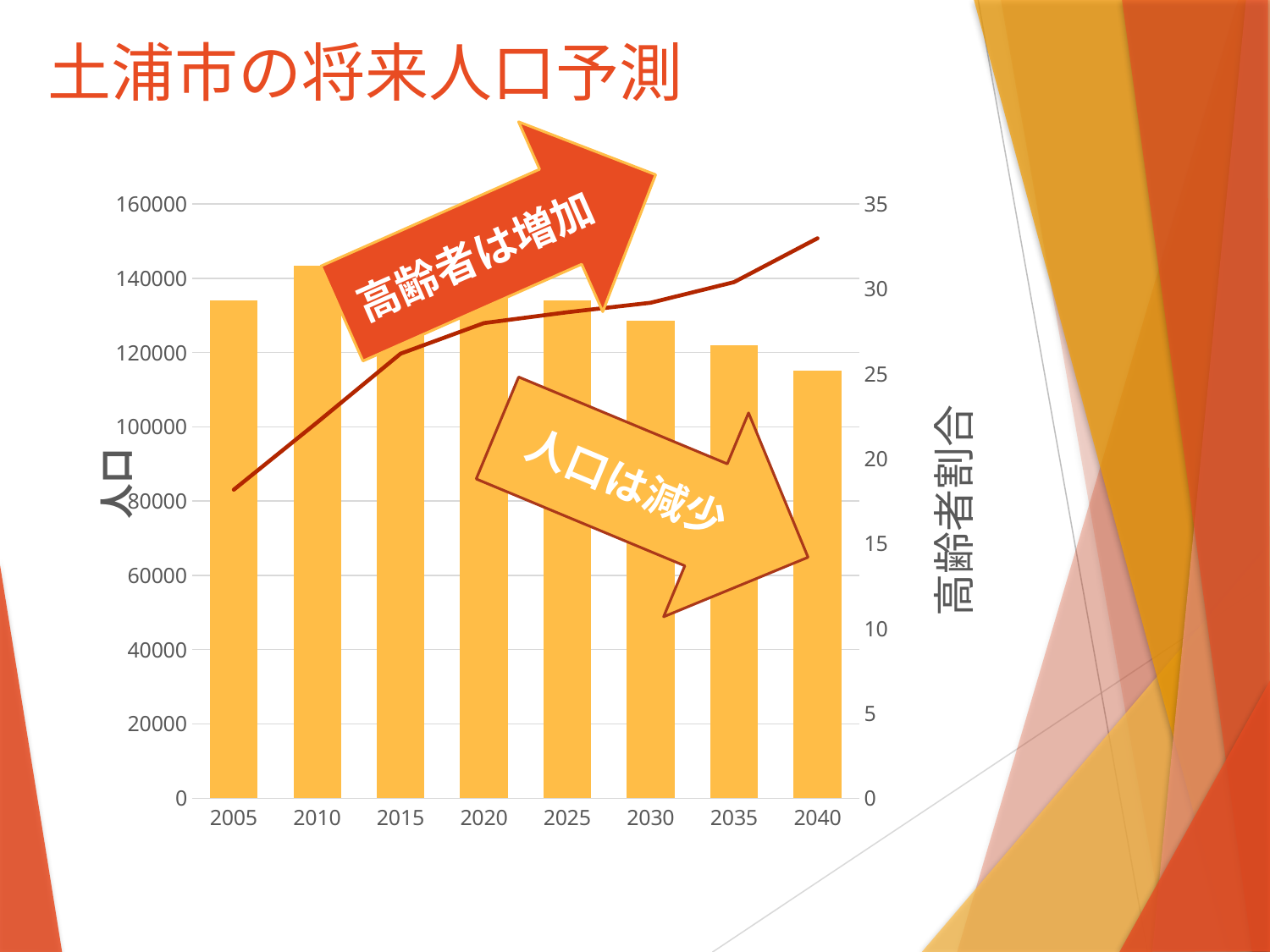
Is the line value for 2005 on the right axis greater or less than 20? less Which year has the shortest bar in the chart? 2040 What kind of chart is shown on the slide? A bar chart with a line series Which bar is taller, 2015 or 2030? 2015 Is the line value for 2040 on the right axis greater or less than 30? greater Does the line series rise or fall from 2005 to 2040? Rises Is the bar value for 2010 greater or less than 140000? greater Which year has the tallest bar in the chart? 2010 How many years are shown on the x axis of the chart? 8 What is the title of the left vertical axis? 人口